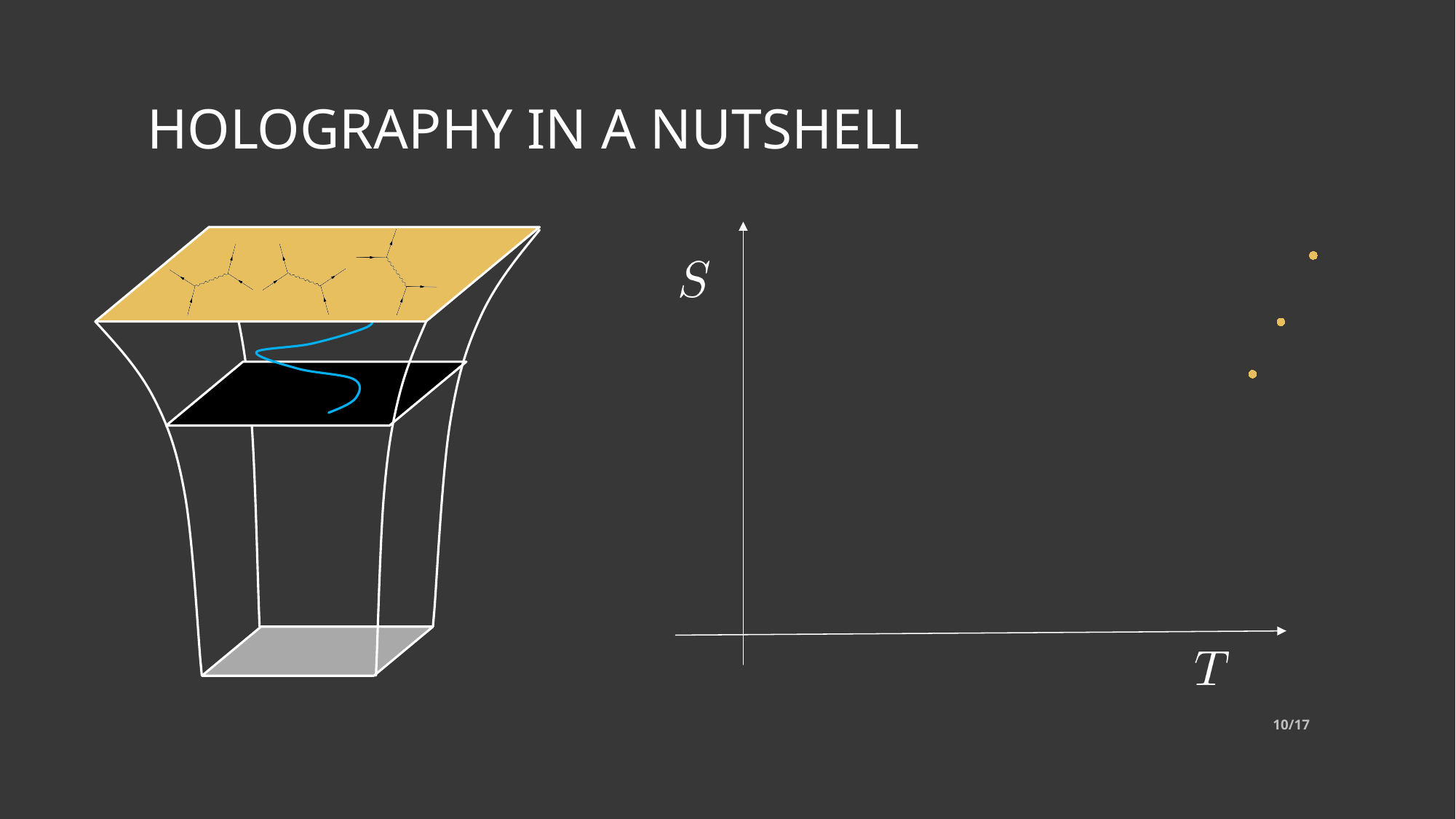
What kind of chart is the S versus T plot on the right? scatter chart On the S versus T chart, do the plotted points rise or fall as T increases? rise How many data points are plotted on the S versus T chart? 3 What label is on the vertical axis of the chart on the right? S What label is on the horizontal axis of the chart on the right? T